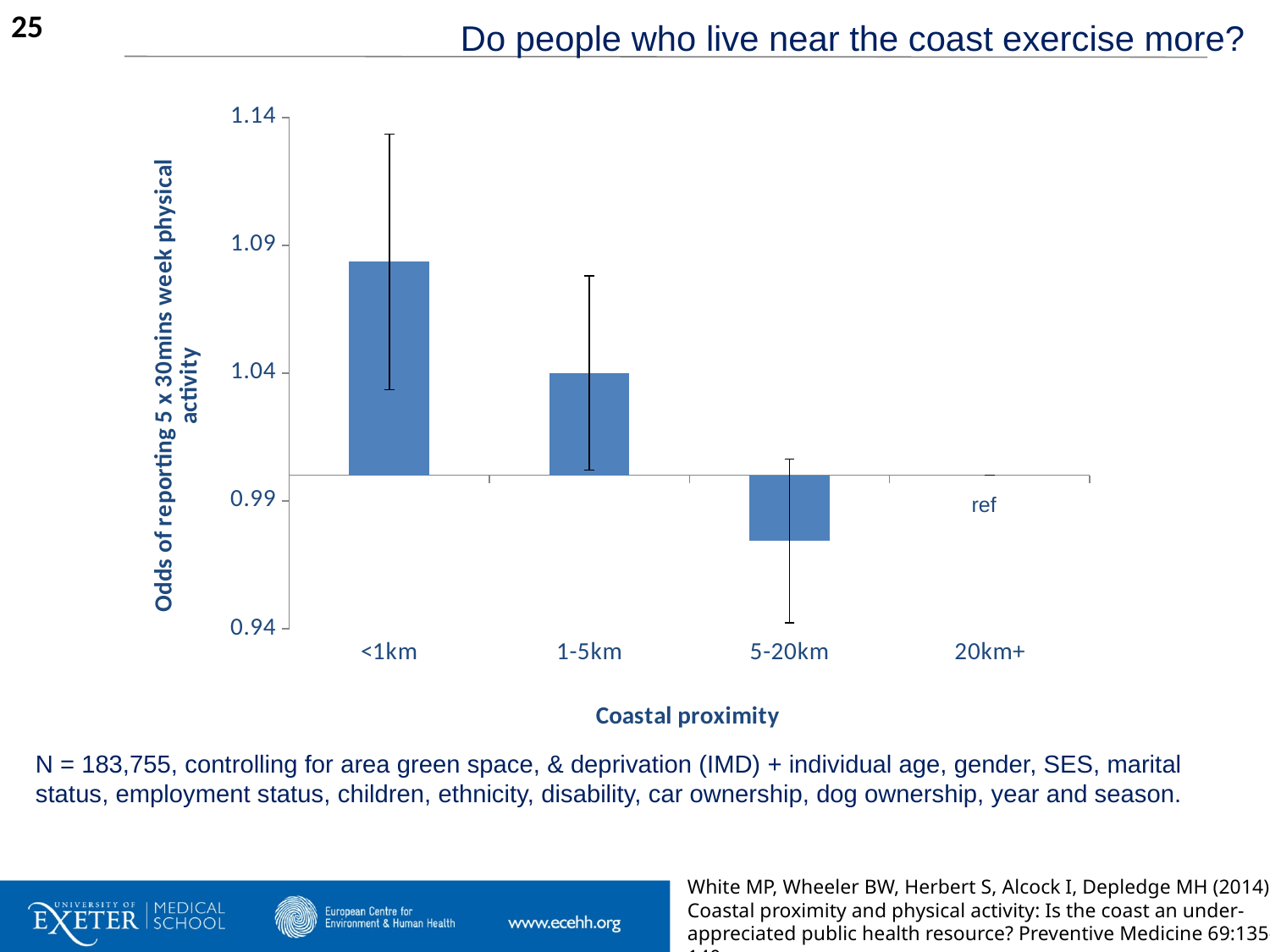
What kind of chart is shown on the slide? bar chart Is the value for <1km greater or less than 1.04? greater Which coastal proximity category has the highest odds of reporting 5 x 30mins week physical activity? <1km Which category is labelled as the reference (ref) group? 20km+ Is the value for 5-20km greater or less than 0.99? less Is the value for <1km greater or less than 1.09? less Which has higher odds of reporting physical activity, <1km or 1-5km? <1km What is the label of the x axis? Coastal proximity Which has higher odds of reporting physical activity, 1-5km or 5-20km? 1-5km How many coastal proximity categories are shown on the x axis? 4 Which coastal proximity category with a plotted bar has the lowest odds of reporting physical activity? 5-20km Do the odds rise or fall as coastal proximity moves from <1km to 5-20km? fall